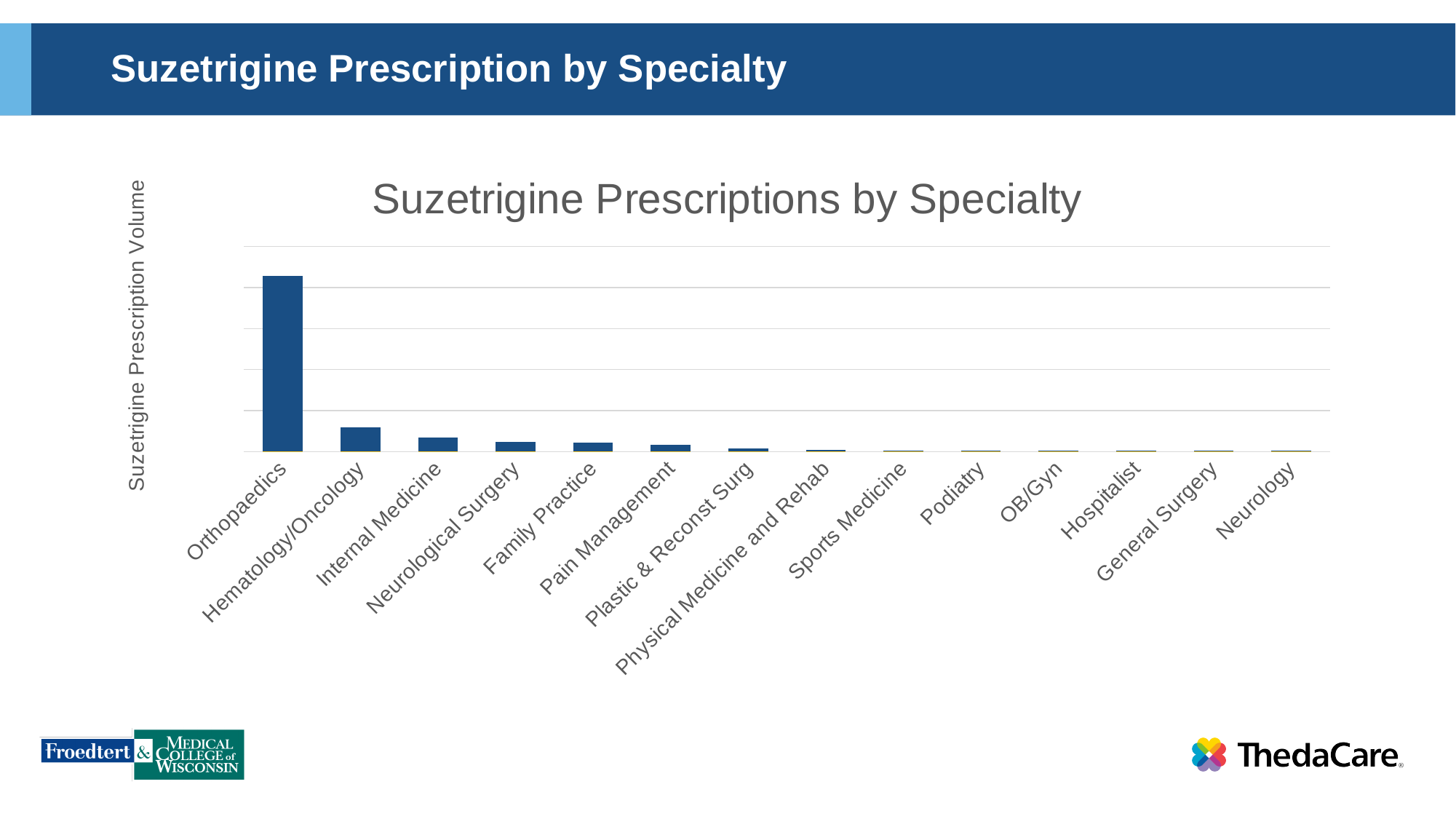
How many specialties are shown on the x axis of the chart? 14 What kind of chart is shown on the slide? Bar chart What is the title of the chart? Suzetrigine Prescriptions by Specialty Which specialty has the highest Suzetrigine prescription volume? Orthopaedics Do the prescription volumes rise or fall moving from left to right along the x axis? Fall Which has a higher prescription volume, Hematology/Oncology or Internal Medicine? Hematology/Oncology What is the label on the vertical axis of the chart? Suzetrigine Prescription Volume Which has a higher prescription volume, Pain Management or Plastic & Reconst Surg? Pain Management Which has a higher prescription volume, Internal Medicine or Sports Medicine? Internal Medicine Which specialty has the second-highest Suzetrigine prescription volume? Hematology/Oncology